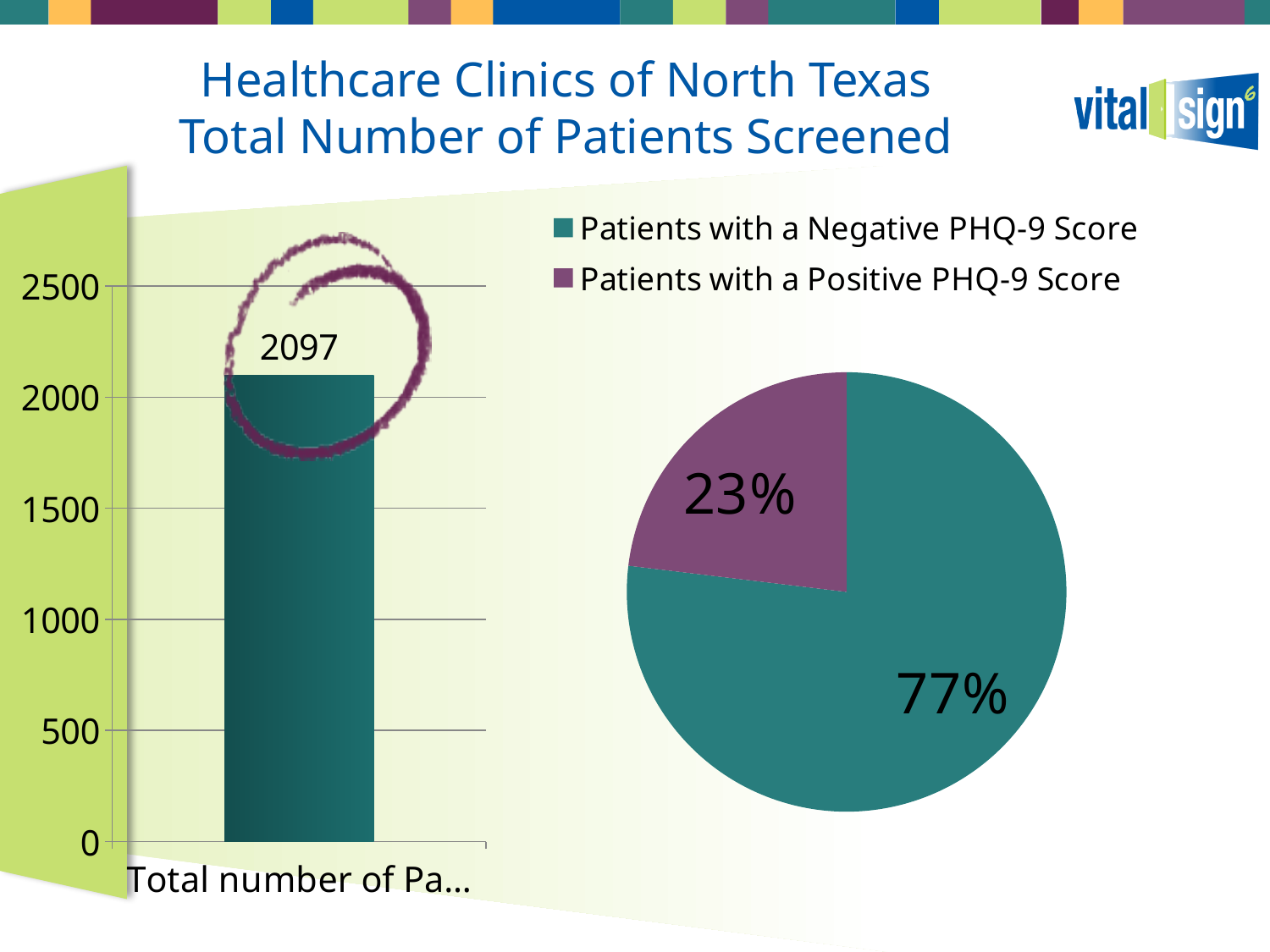
On the bar chart on the left, is the value of the bar greater or less than 2000? greater On the bar chart on the left, what value is shown for the single bar? 2097 On the pie chart on the right, what share is shown for Patients with a Negative PHQ-9 Score? 77% What kind of chart is on the left side of the slide? bar chart On the pie chart on the right, what share is shown for Patients with a Positive PHQ-9 Score? 23% On the pie chart on the right, what is the difference in percentage points between the Negative and Positive PHQ-9 Score slices? 54 What kind of chart is on the right side of the slide? pie chart On the pie chart on the right, what colour is the slice for Patients with a Positive PHQ-9 Score? purple On the pie chart on the right, how many entries does the legend list? 2 On the bar chart on the left, how many bars are plotted? 1 On the pie chart on the right, which slice is larger: Patients with a Negative PHQ-9 Score or Patients with a Positive PHQ-9 Score? Patients with a Negative PHQ-9 Score On the bar chart on the left, is the value of the bar greater or less than 2500? less